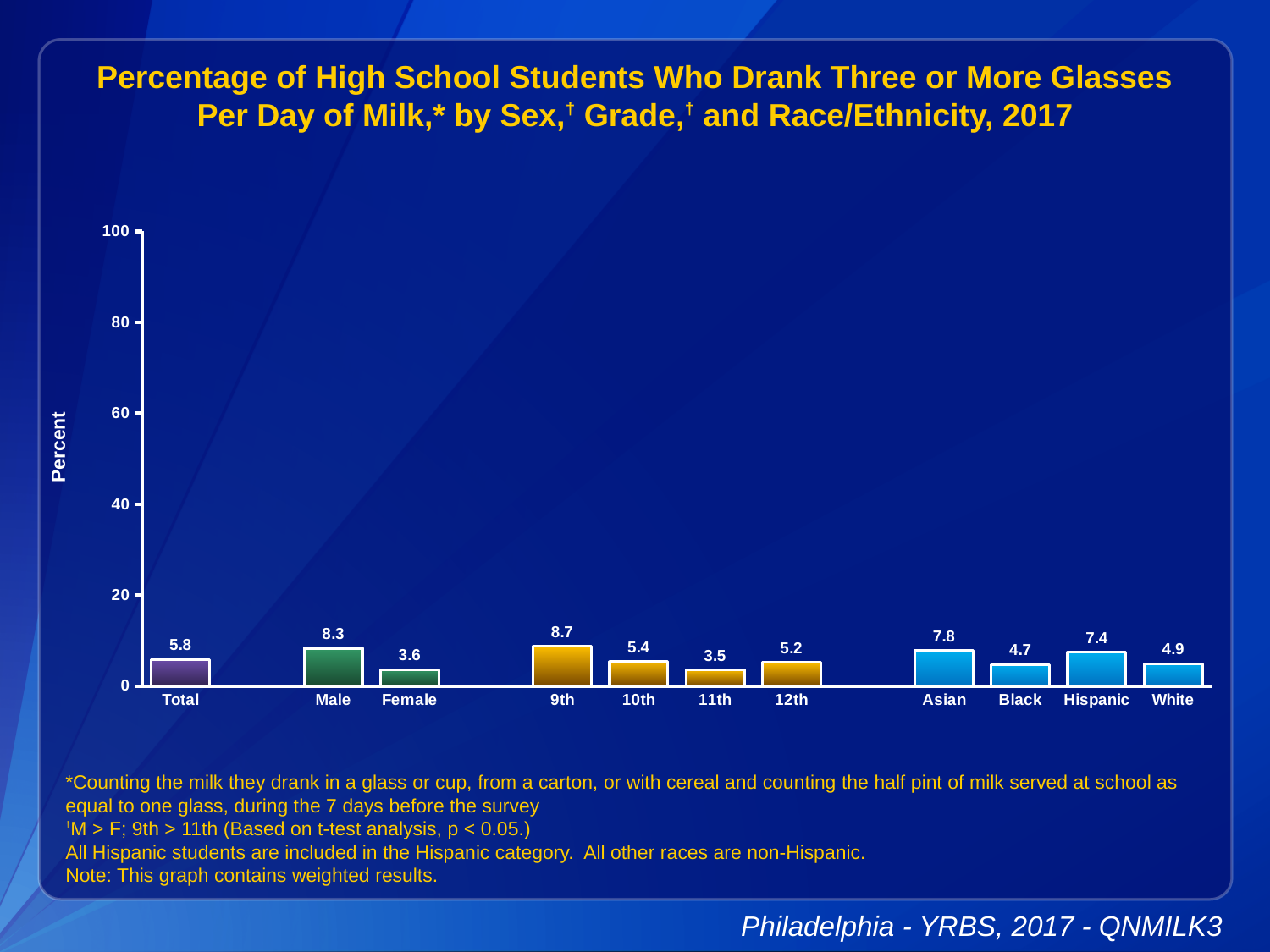
Is the value for 9th grade greater or less than 20? less Which category has the highest value? 9th What is the value for Hispanic? 7.4 What is the value for 11th grade? 3.5 What kind of chart is this? bar chart How many categories are shown on the x axis? 11 What is the label of the y axis? Percent What is the value for Total? 5.8 Which is larger, the value for Asian or the value for Black? Asian Which category has the lowest value? 11th What is the difference between the Male and Female values? 4.7 What is the value for Male? 8.3